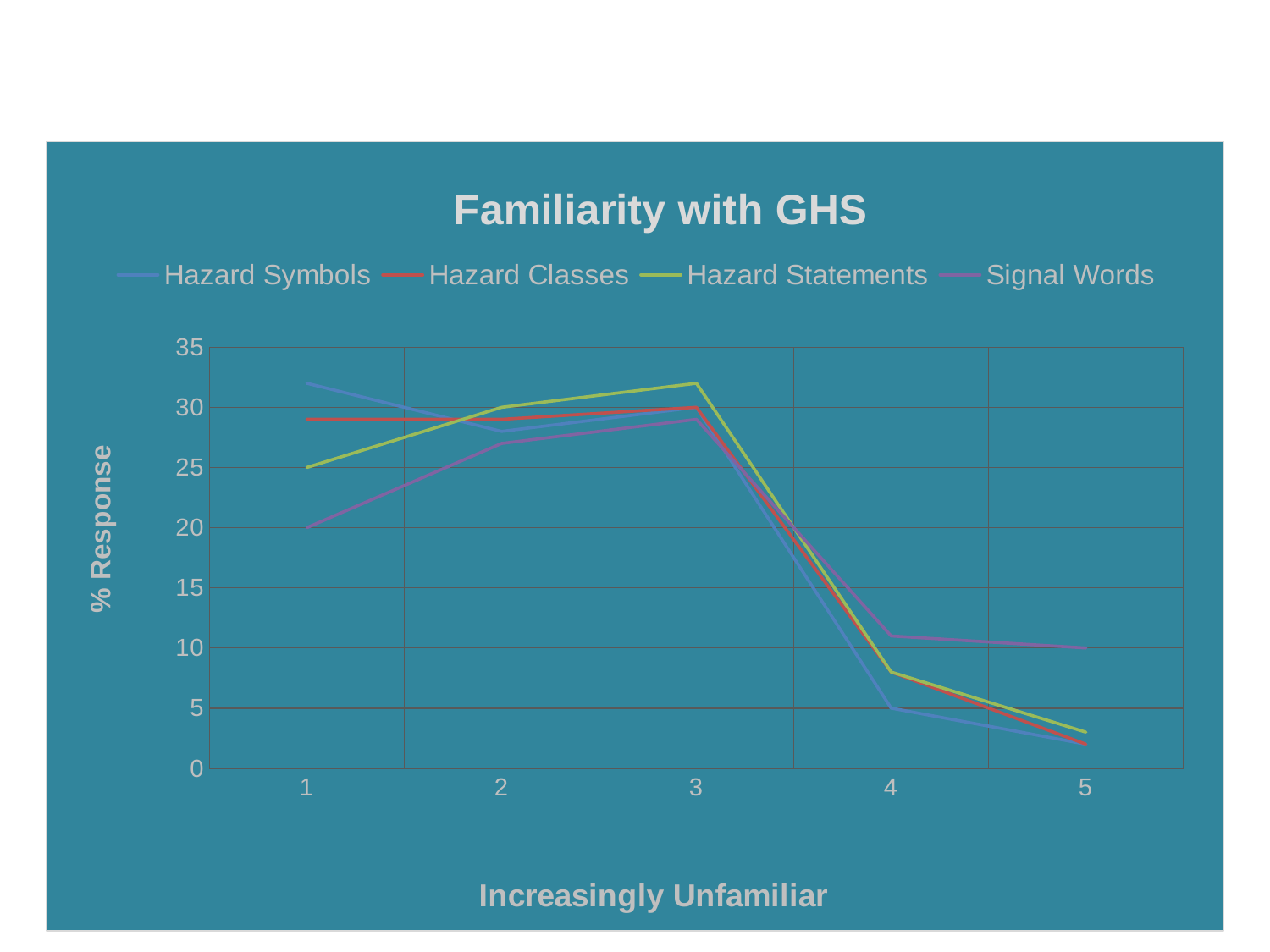
Which series has the lowest value at x = 1? Signal Words How many points are plotted along the x axis for each series? 5 How many series does the legend list? 4 What kind of chart is shown on the slide? line chart At x = 5, which is larger: the value for Signal Words or the value for Hazard Symbols? Signal Words Is the value for Hazard Symbols at x = 1 greater or less than 30? greater Which series has the highest value at x = 1? Hazard Symbols Do the values for Signal Words rise or fall from x = 3 to x = 5? fall Which series has the highest value at x = 5? Signal Words What is the title of the chart? Familiarity with GHS Is the value for Hazard Classes at x = 4 greater or less than 10? less What is the label on the y axis? % Response